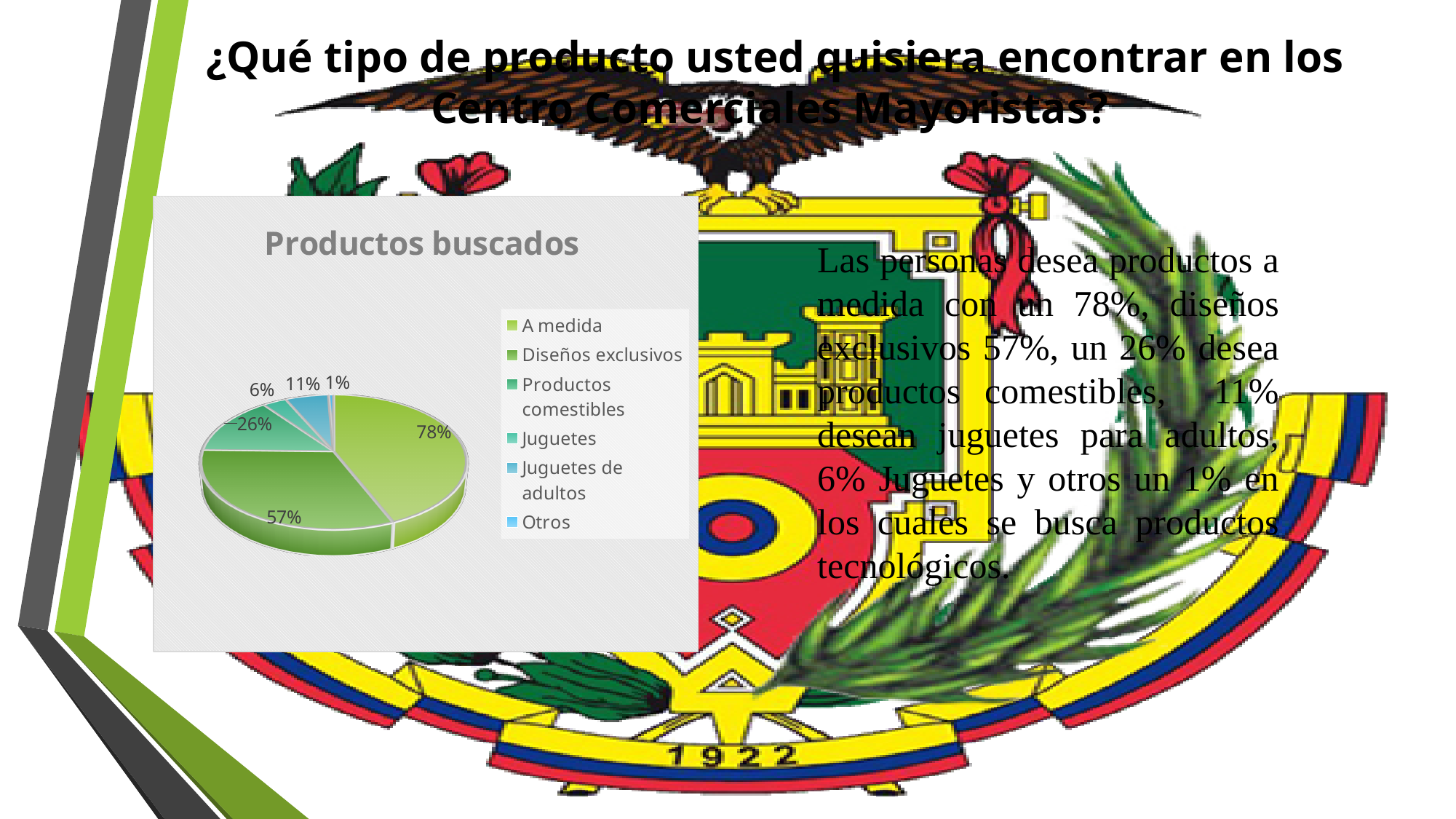
What is the title of the chart? Productos buscados What percentage is shown for 'Juguetes'? 6% What percentage is shown for 'Juguetes de adultos'? 11% What type of chart is shown on the slide? Pie chart What percentage is shown for 'Diseños exclusivos'? 57% Which category has the smallest slice of the pie? Otros How many categories does the legend of the chart list? 6 What is the difference between the percentages for 'A medida' and 'Diseños exclusivos'? 21% What percentage is shown for 'A medida'? 78% Which is larger, the slice for 'Juguetes' or the slice for 'Juguetes de adultos'? Juguetes de adultos Which category has the largest slice of the pie? A medida What percentage is shown for 'Productos comestibles'? 26%